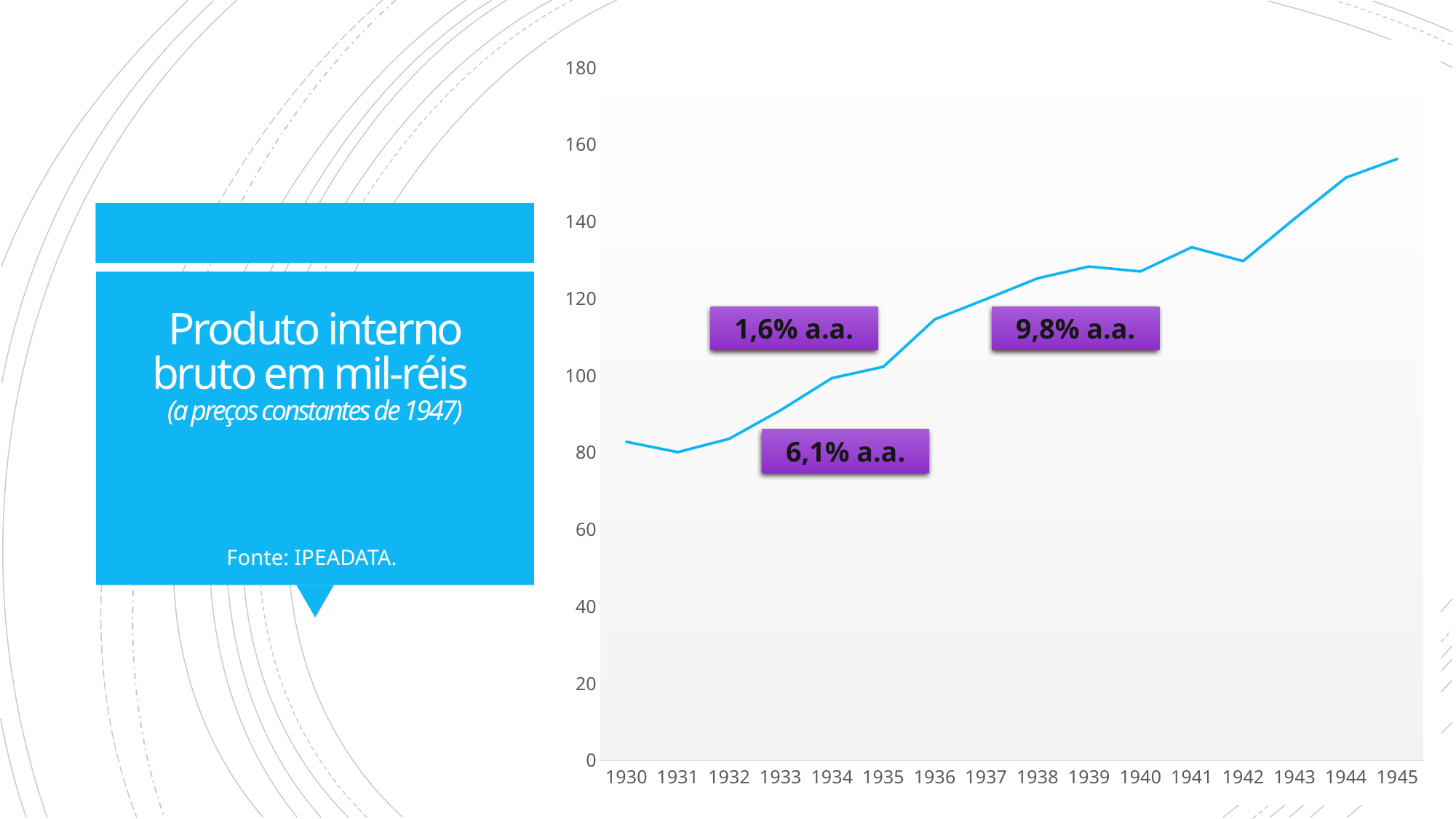
Is the value for 1931 greater or less than 100? less What annual growth rate is shown in the purple label placed over the right part of the line? 9,8% a.a. Is the value for 1936 greater or less than 100? greater Which year has the larger value, 1930 or 1945? 1945 Which year has the highest value on the chart? 1945 How many years are plotted along the x axis of the chart? 16 Is the value for 1945 greater or less than 140? greater What kind of chart is shown on the slide? line chart What is the title of the chart given in the blue box on the slide? Produto interno bruto em mil-réis (a preços constantes de 1947) Overall, do the values rise or fall from 1930 to 1945? rise Which year has the lowest value on the chart? 1931